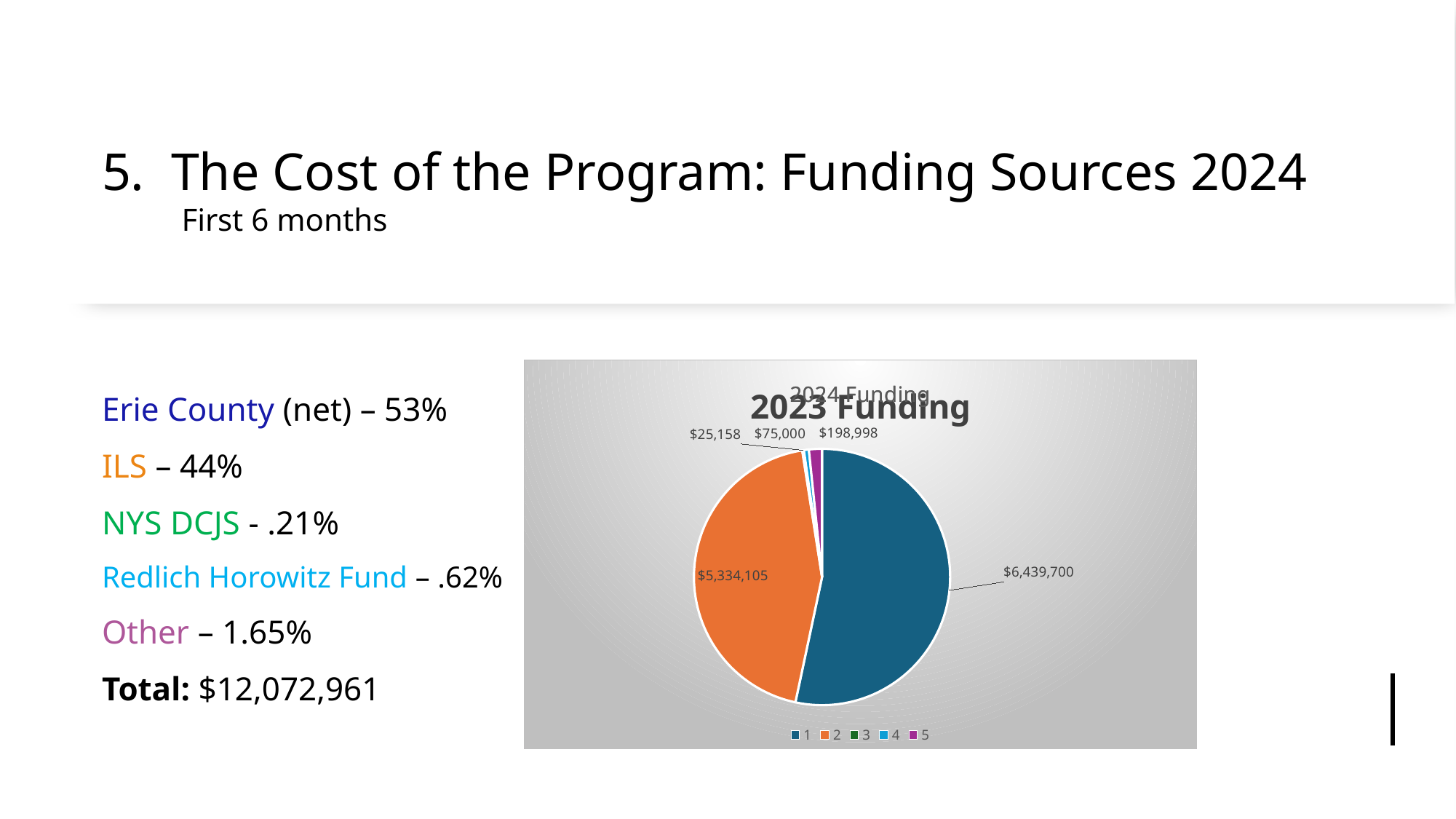
What is the difference between the dark blue slice ($6,439,700) and the orange slice ($5,334,105) in the pie chart? $1,105,595 What kind of chart is shown on the slide? pie chart How many entries does the pie chart's legend list? 5 Which slice is larger in the pie chart, the dark blue slice (1) or the orange slice (2)? dark blue slice (1) What is the value of the orange slice (legend entry 2) in the pie chart? $5,334,105 What is the smallest value labelled on the pie chart? $25,158 What is the value of the dark blue slice (legend entry 1) in the pie chart? $6,439,700 What is the value of the largest slice of the pie chart? $6,439,700 What is the total of all five values labelled on the pie chart? $12,072,961 What is the value of the purple slice (legend entry 5) in the pie chart? $198,998 What labels does the pie chart's legend show? 1, 2, 3, 4, 5 How many slices does the pie chart have? 5